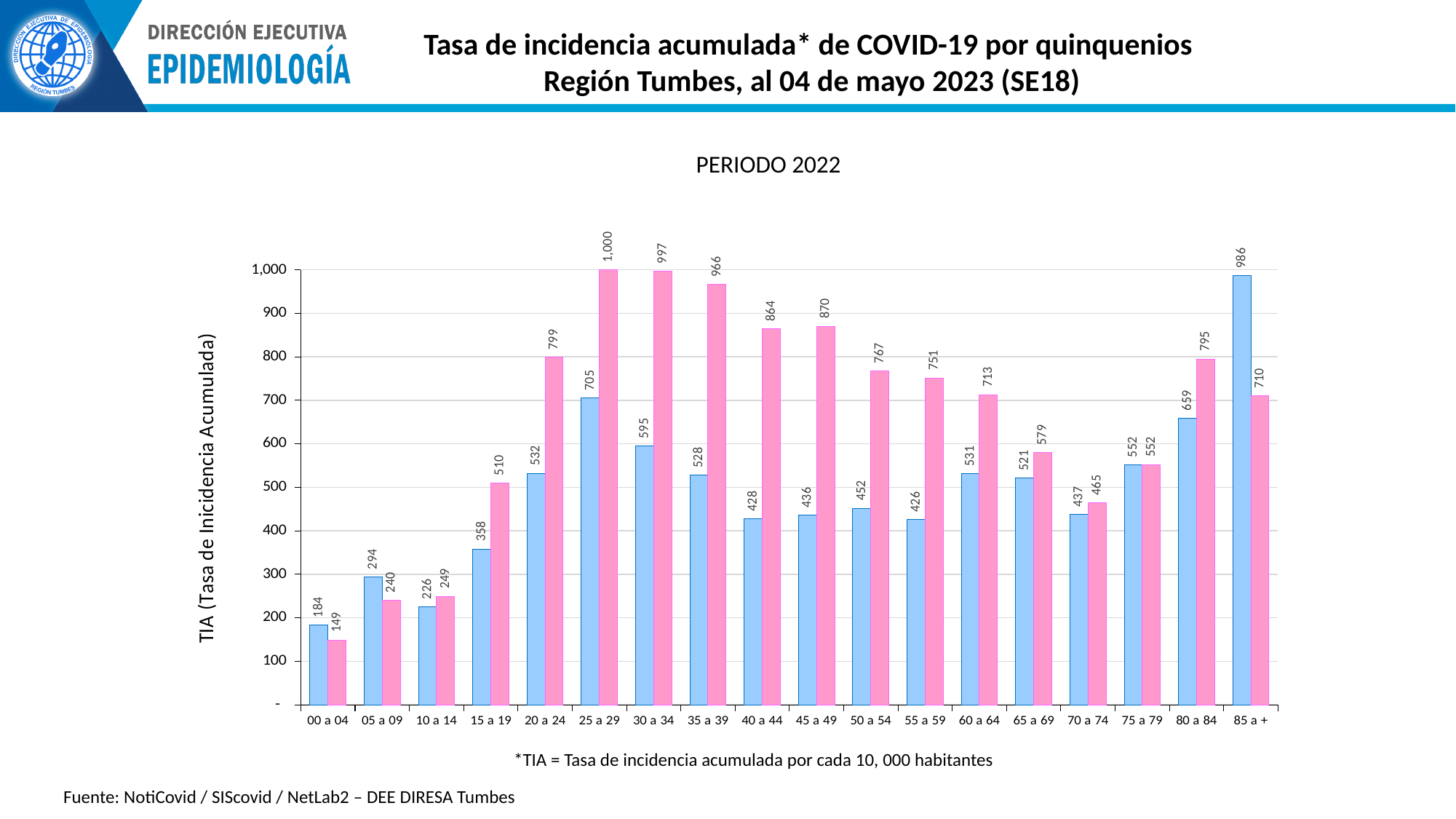
Is the value of the blue bar for the 15 a 19 age group greater or less than 400? less What is the difference between the pink bar and the blue bar for the 30 a 34 age group? 402 Which age group has the lowest pink bar? 00 a 04 Which age group has the highest pink bar? 25 a 29 How many age groups are shown on the x axis? 18 What is the value of the blue bar for the 25 a 29 age group? 705 What kind of chart is shown on the slide? bar chart What is the value of the pink bar for the 45 a 49 age group? 870 For the 80 a 84 age group, which is larger, the blue bar or the pink bar? the pink bar What is the title shown above the chart? PERIODO 2022 Which age group has the lowest blue bar? 00 a 04 What is the value of the blue bar for the 85 a + age group? 986